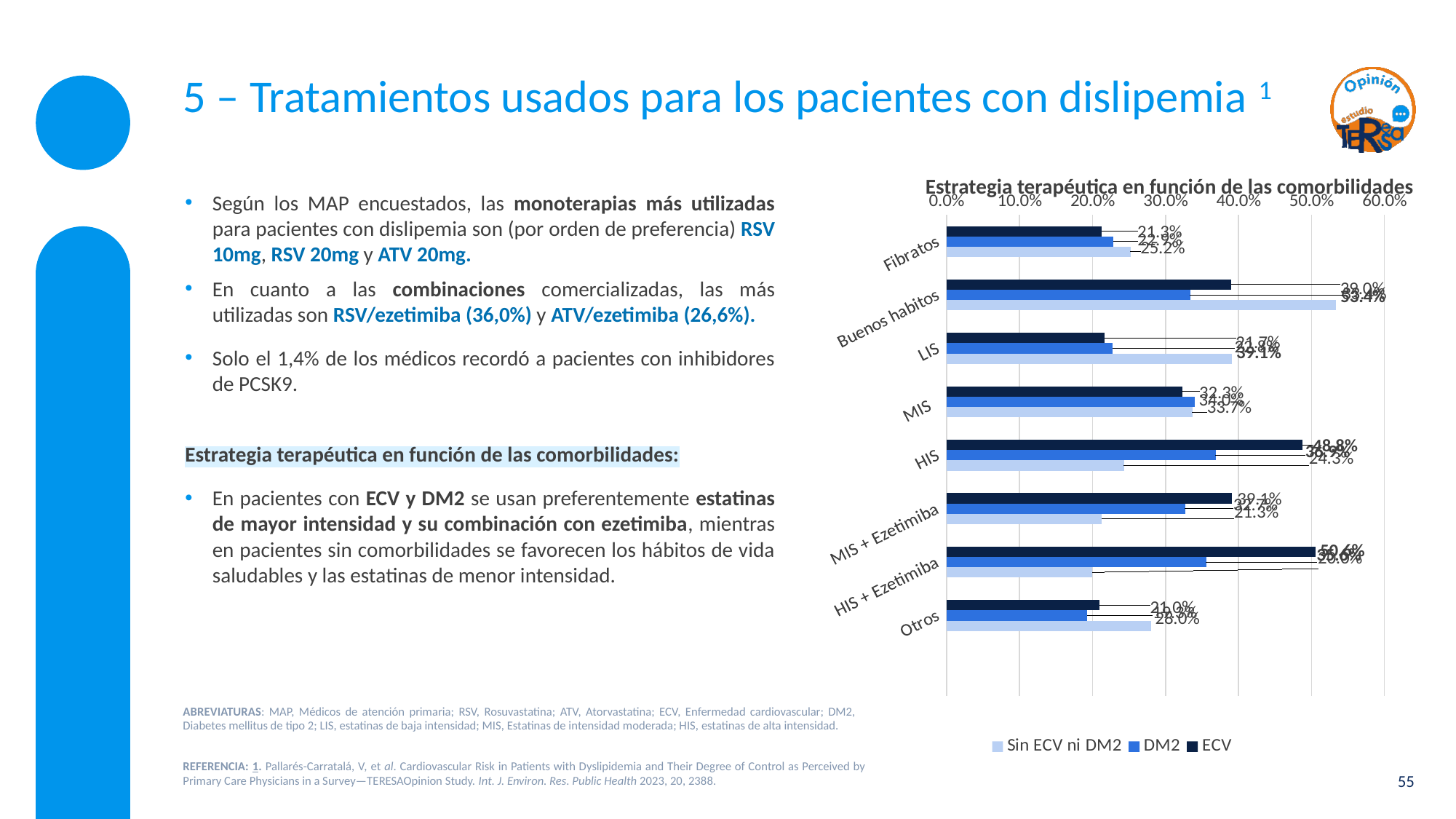
Is the value for Buenos habitos in the Sin ECV ni DM2 series greater or less than 50.0%? greater What is the title of the chart? Estrategia terapéutica en función de las comorbilidades Which category has the highest value in the Sin ECV ni DM2 series? Buenos habitos What is the value for HIS in the ECV series? 48.8% What is the value for HIS + Ezetimiba in the ECV series? 50.6% What kind of chart is shown on the slide? bar chart How many categories are shown on the chart's vertical axis? 8 What is the value for Fibratos in the Sin ECV ni DM2 series? 25.2% How many series does the chart legend list? 3 What is the difference between the ECV value (48.8%) and the Sin ECV ni DM2 value (24.3%) for HIS? 24.5 percentage points What is the value for Otros in the Sin ECV ni DM2 series? 28.0% For HIS, which is larger: the ECV value or the Sin ECV ni DM2 value? ECV